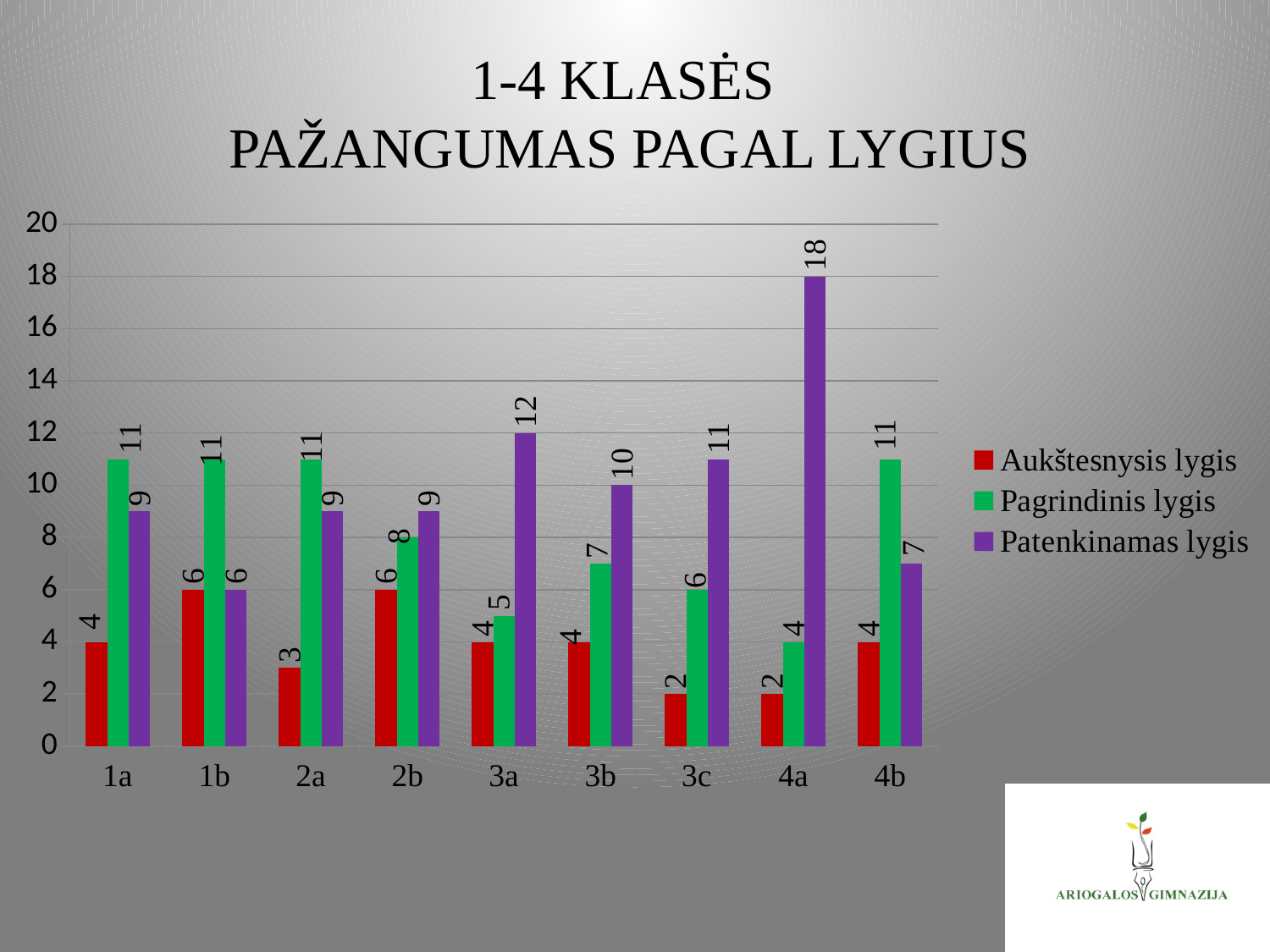
Which is larger for class 2b: Pagrindinis lygis or Patenkinamas lygis? Patenkinamas lygis What kind of chart is shown on the slide? Bar chart Which class has the lowest Pagrindinis lygis value? 4a What is the value of Pagrindinis lygis for class 3a? 5 How many series does the legend list? 3 How many classes are shown on the x axis? 9 Which class has the highest Patenkinamas lygis value? 4a What is the difference between the Patenkinamas lygis and Aukštesnysis lygis values for class 4a? 16 What is the value of Patenkinamas lygis for class 4a? 18 What is the total of the three values for class 3c? 19 What is the value of Aukštesnysis lygis for class 1b? 6 What is the value of Patenkinamas lygis for class 3b? 10